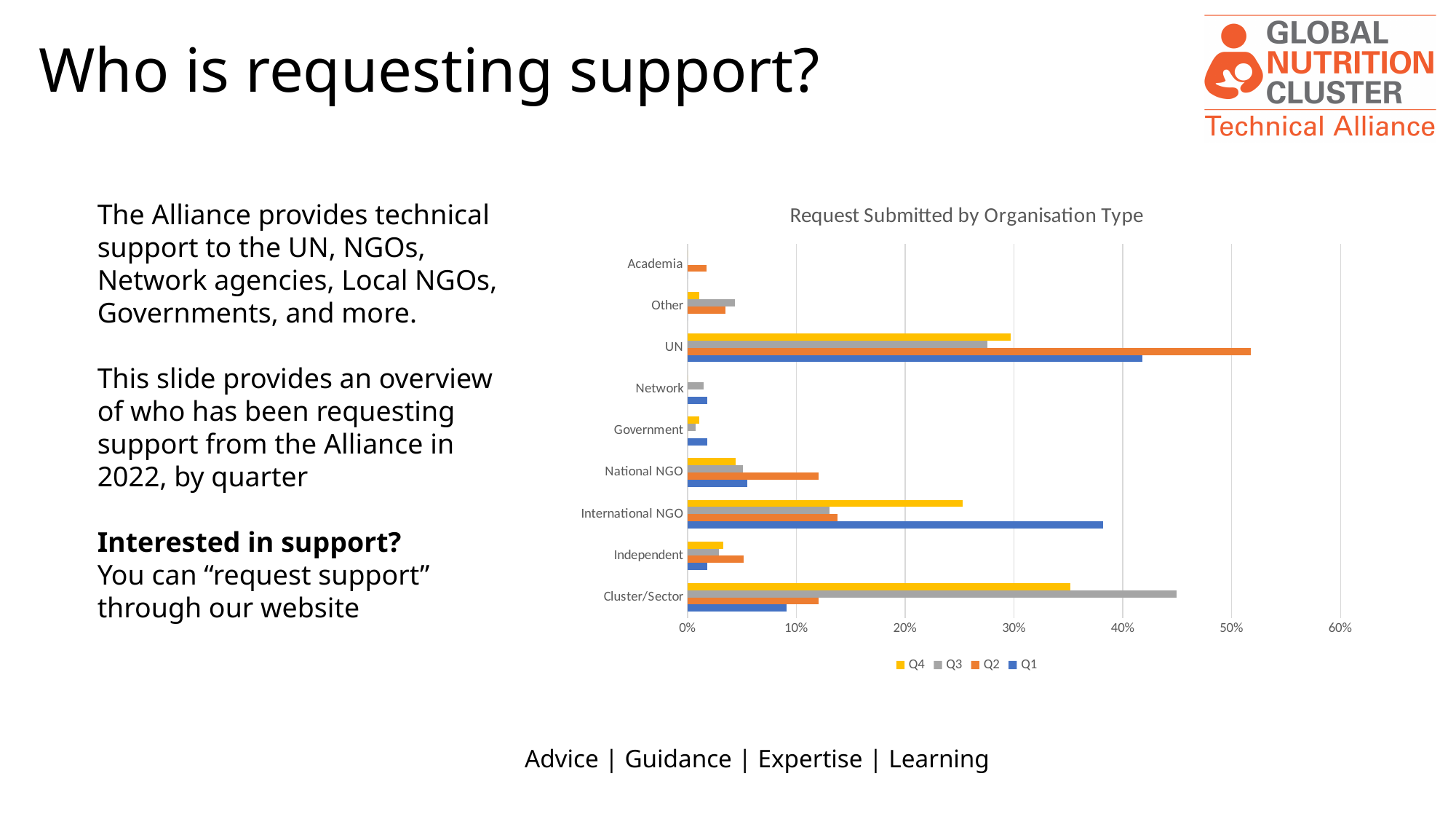
For Cluster/Sector, which is larger: the Q4 value or the Q1 value? Q4 How many series does the chart legend list? 4 How many organisation types are shown on the chart? 9 Is the Q2 value for UN greater or less than 50%? greater For UN, which is larger: the Q2 value or the Q1 value? Q2 Which organisation type has the highest Q1 value? UN Is the Q3 value for Cluster/Sector greater or less than 40%? greater What type of chart is shown on the slide? bar chart What is the title of the chart? Request Submitted by Organisation Type Which organisation type has the highest Q3 value? Cluster/Sector Which organisation type has the highest Q2 value? UN Is the Q1 value for International NGO greater or less than 40%? less